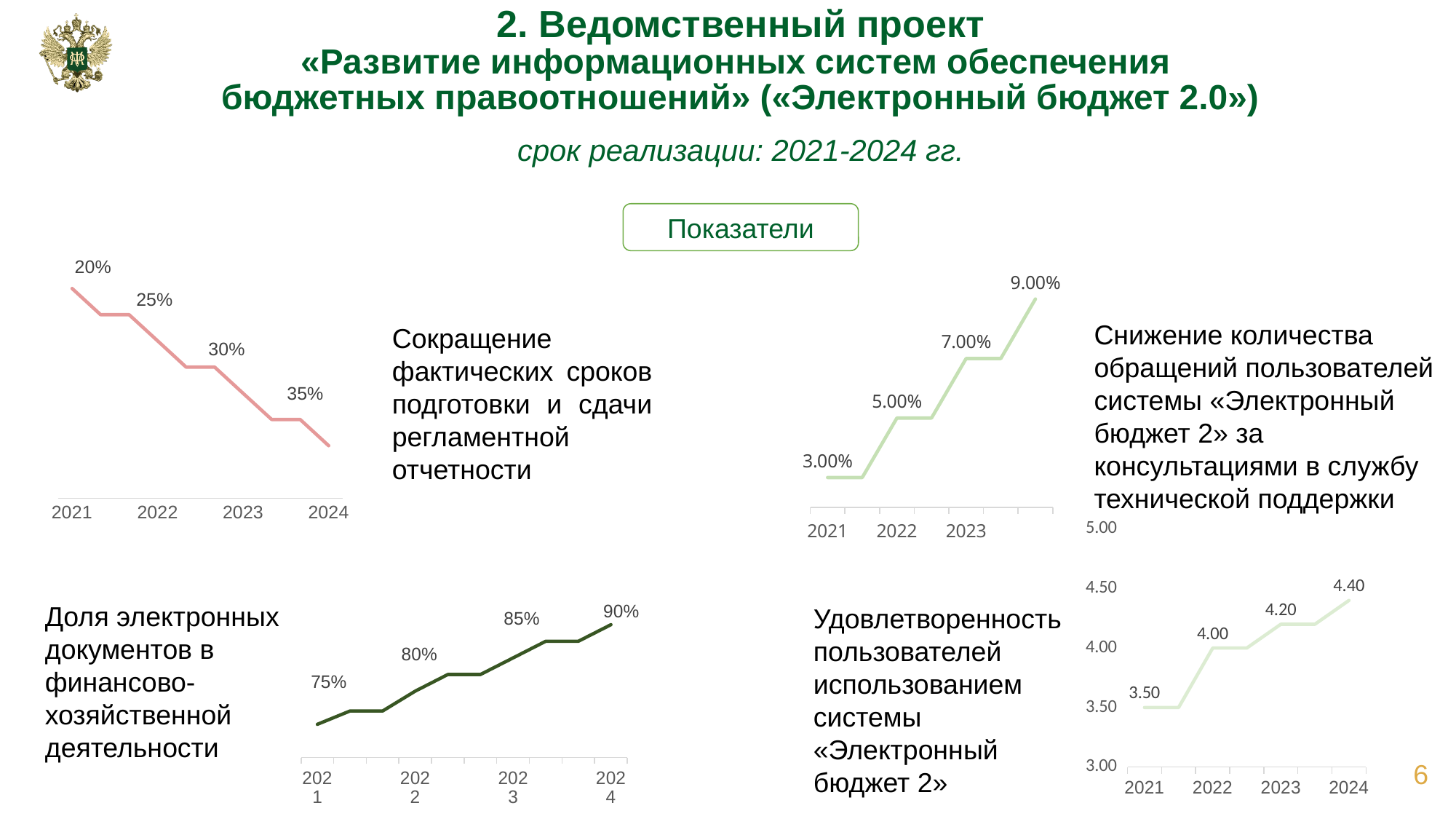
What type of chart is used for 'Доля электронных документов в финансово-хозяйственной деятельности'? line chart On the chart 'Удовлетворенность пользователей использованием системы «Электронный бюджет 2»', which year has the lowest value? 2021 On the chart 'Сокращение фактических сроков подготовки и сдачи регламентной отчетности', what is the value for 2023? 30% On the chart 'Удовлетворенность пользователей использованием системы «Электронный бюджет 2»', what is the value for 2023? 4.20 On the chart 'Сокращение фактических сроков подготовки и сдачи регламентной отчетности', which year has the highest labelled value? 2024 On the chart 'Доля электронных документов в финансово-хозяйственной деятельности', what is the value for 2021? 75% On the chart 'Доля электронных документов в финансово-хозяйственной деятельности', what is the value for 2024? 90% On the chart 'Доля электронных документов в финансово-хозяйственной деятельности', do the values rise or fall from 2021 to 2024? rise On the chart 'Снижение количества обращений пользователей системы «Электронный бюджет 2»', what is the difference between the 2023 and 2021 values? 4.00% On the chart 'Снижение количества обращений пользователей системы «Электронный бюджет 2»', what is the value for 2022? 5.00% On the chart 'Удовлетворенность пользователей использованием системы «Электронный бюджет 2»', what is the difference between the 2024 and 2021 values? 0.90